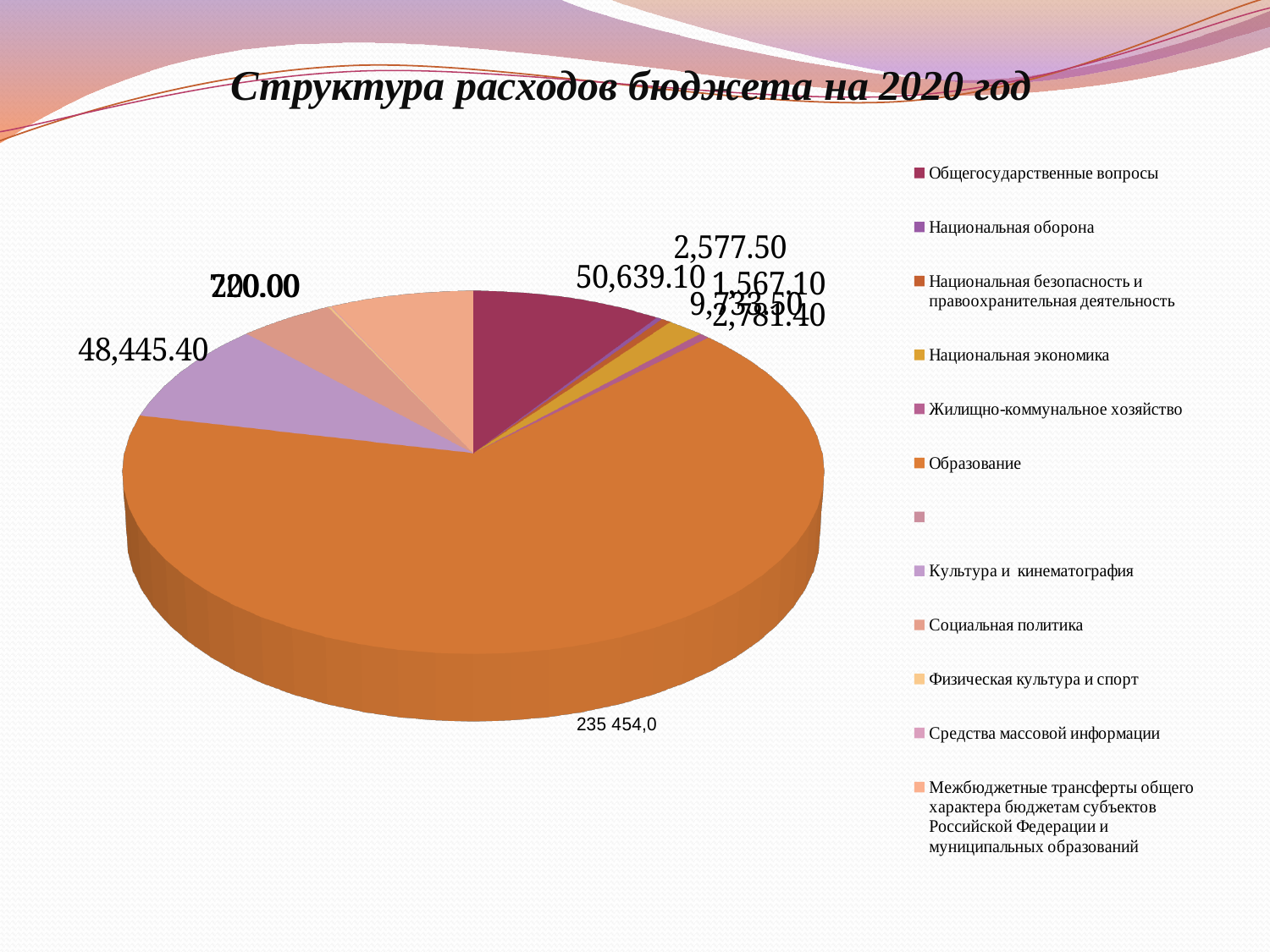
What value is shown for Культура и кинематография? 48,445.40 Which is larger, Общегосударственные вопросы or Культура и кинематография? Общегосударственные вопросы What is the difference between the values for Общегосударственные вопросы and Культура и кинематография? 2,193.70 What value is shown for Образование? 235 454,0 What is the title of the chart? Структура расходов бюджета на 2020 год What value is shown for Национальная оборона? 1,567.10 What colour is the slice for Образование? orange What value is shown for Общегосударственные вопросы? 50,639.10 What kind of chart is shown on the slide? pie chart Which category has the largest slice of the pie? Образование Which is larger, Образование or Общегосударственные вопросы? Образование